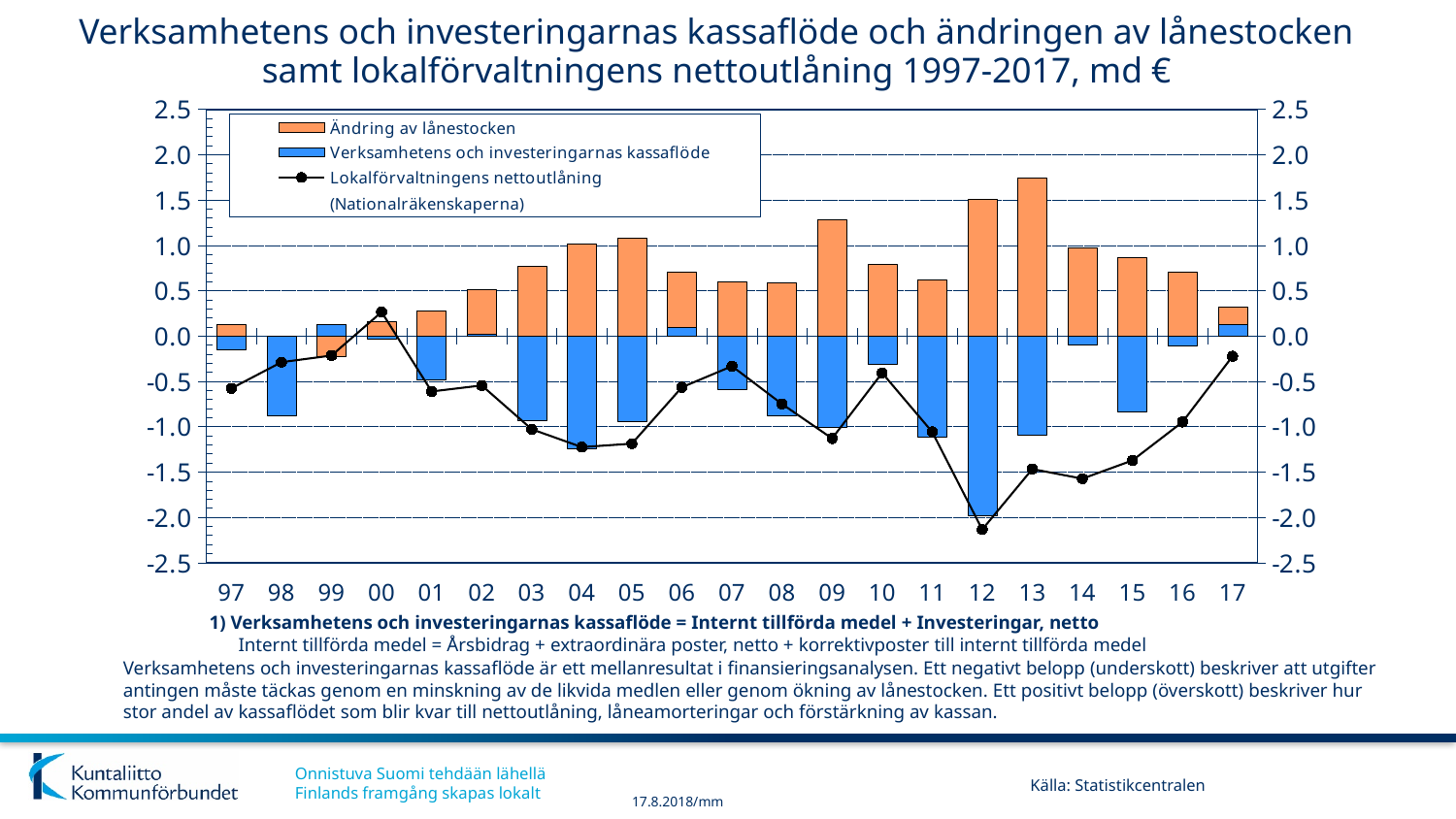
How many series does the legend list? 3 What kind of chart is shown on the slide? A combined bar and line chart In which year does the line for Lokalförvaltningens nettoutlåning reach its highest point? 00 In which year is the bar for Ändring av lånestocken highest? 13 Is the value for Verksamhetens och investeringarnas kassaflöde in 98 greater or less than -0.5? less How many years are shown on the x axis? 21 Is the value for Lokalförvaltningens nettoutlåning in 12 greater or less than -2.0? less Does the line for Lokalförvaltningens nettoutlåning rise or fall from 12 to 17? rise Is the value for Ändring av lånestocken in 13 greater or less than 1.5? greater In which year is the bar for Verksamhetens och investeringarnas kassaflöde lowest? 12 Which year has the larger Ändring av lånestocken bar, 12 or 13? 13 In which year does the line for Lokalförvaltningens nettoutlåning reach its lowest point? 12